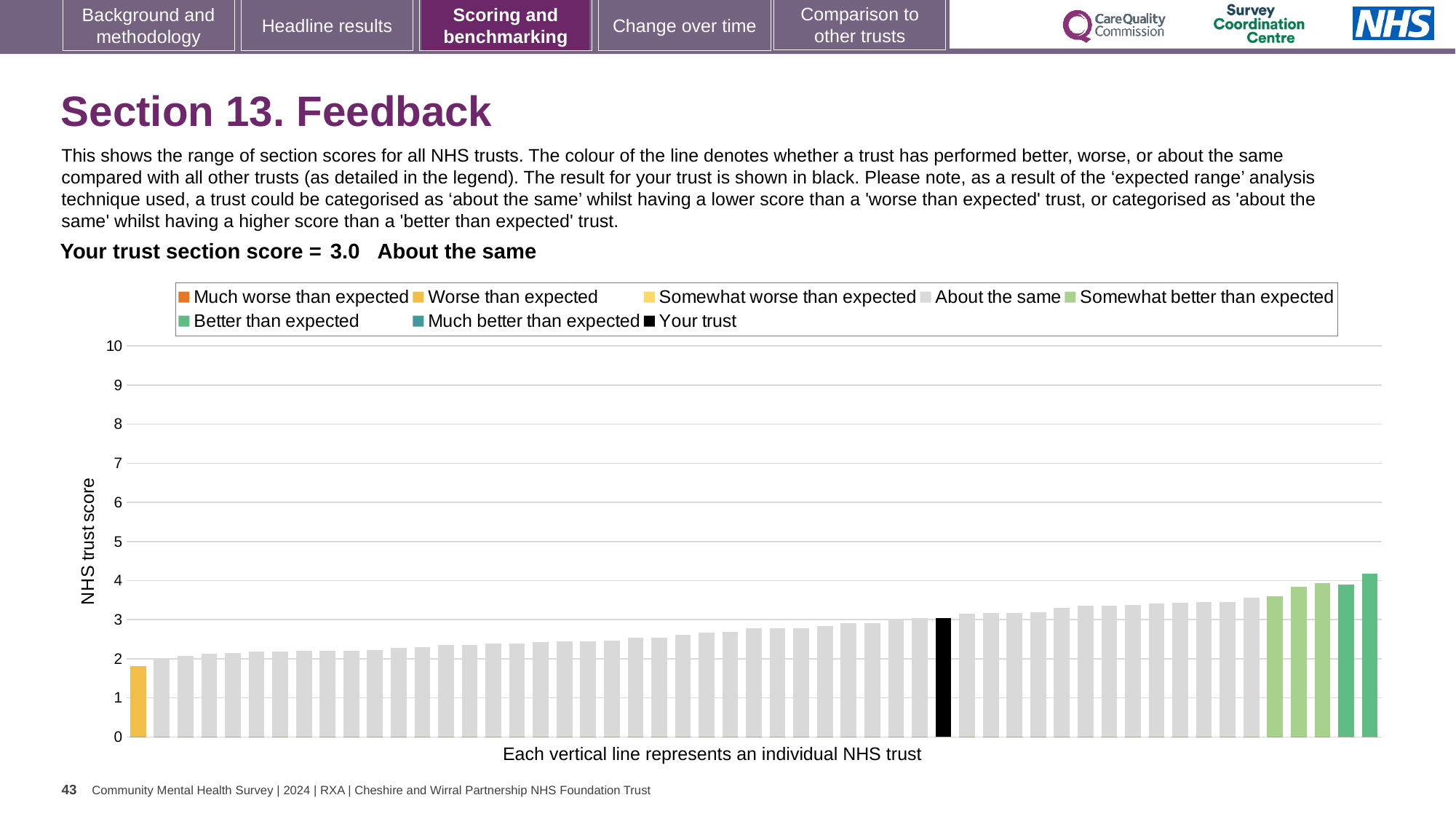
What is the highest value shown on the y axis? 10 Is the value of the leftmost bar greater or less than 2? less What is the section score for your trust? 3.0 Do the bar values rise or fall from left to right along the x axis? rise How many entries does the chart legend list? 8 What kind of chart is shown on the slide? bar chart Is the value of the rightmost bar greater or less than 3? greater Is the value for your trust (the black bar) greater or less than 2? greater Which is larger, the rightmost bar or the black bar for your trust? the rightmost bar Which performance category is your trust placed in for Section 13? About the same What is the label of the y axis? NHS trust score